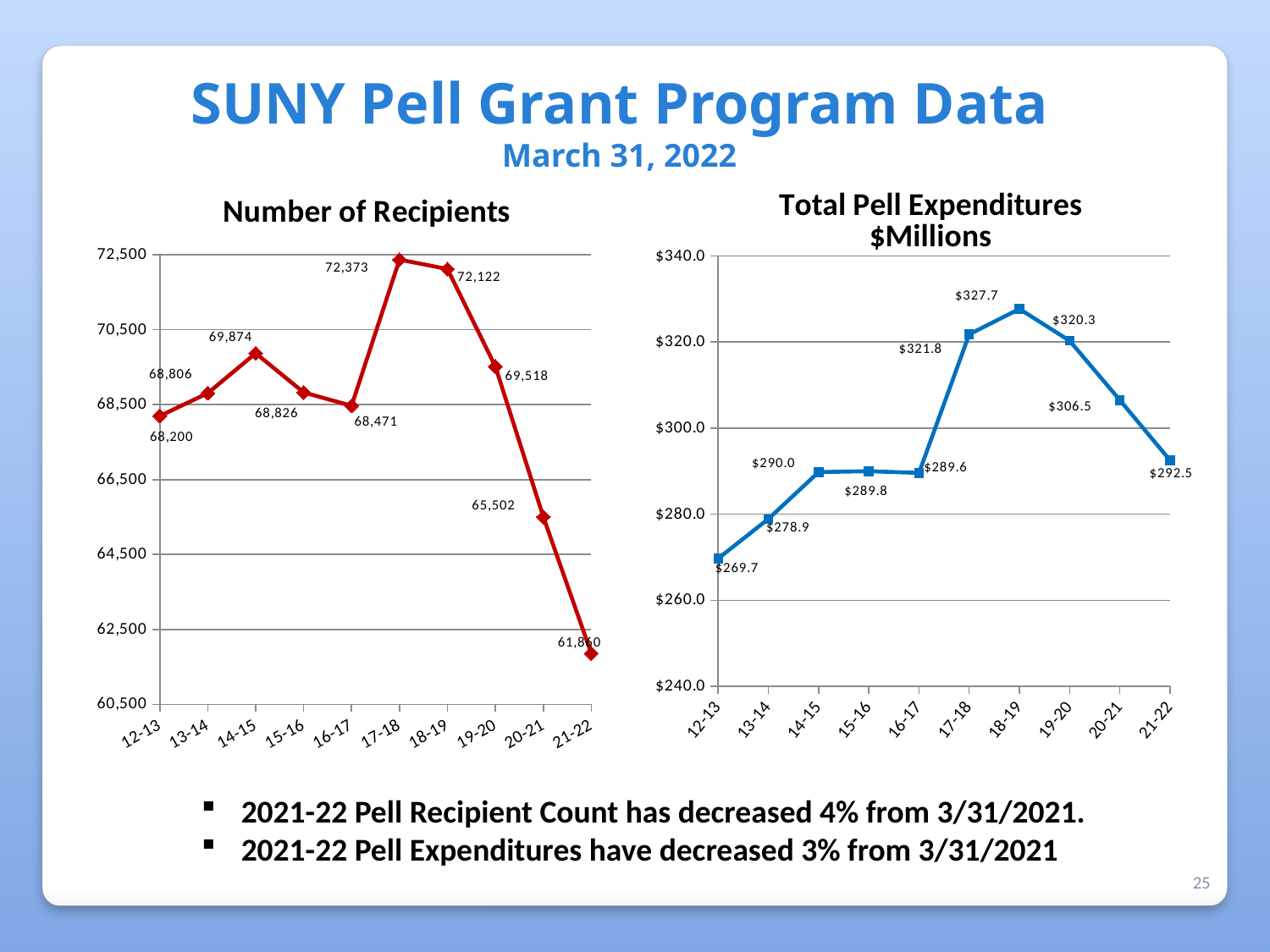
What kind of chart is the Number of Recipients chart? line chart In the Total Pell Expenditures $Millions chart, which year has the lowest expenditure? 12-13 In the Number of Recipients chart, what is the value for 12-13? 68,200 In the Number of Recipients chart, what is the difference between the values for 17-18 and 18-19? 251 In the Number of Recipients chart, which year has the highest number of recipients? 17-18 In the Number of Recipients chart, is the value for 21-22 greater or less than 62,500? less In the Total Pell Expenditures $Millions chart, what is the value for 21-22? $292.5 In the Number of Recipients chart, what is the value for 17-18? 72,373 How many years are plotted in the Total Pell Expenditures $Millions chart? 10 In the Total Pell Expenditures $Millions chart, which is larger, the value for 19-20 or the value for 20-21? 19-20 In the Total Pell Expenditures $Millions chart, what is the difference between the values for 18-19 and 12-13? $58.0 In the Total Pell Expenditures $Millions chart, what is the value for 18-19? $327.7